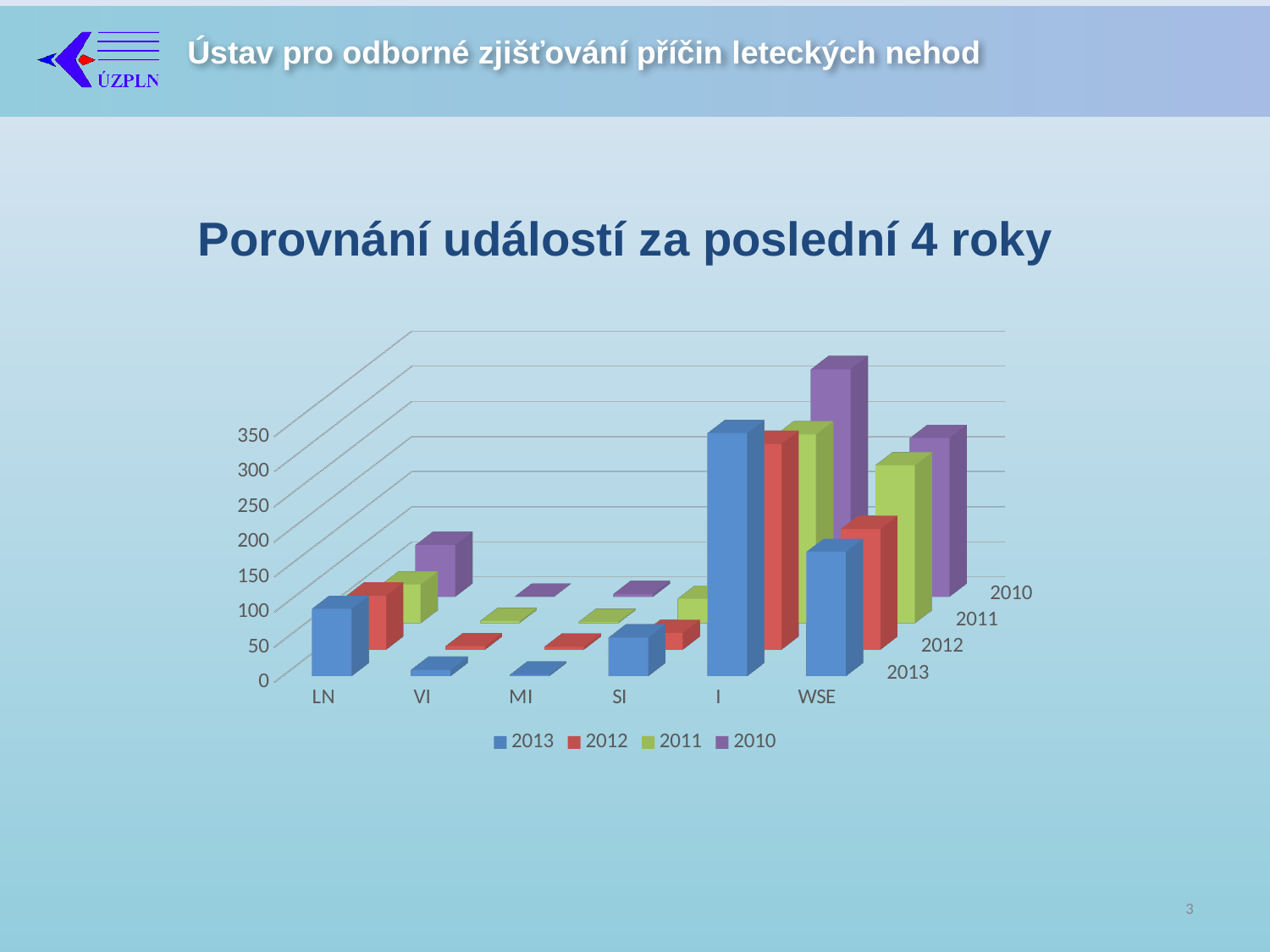
Is the 2013 value for I greater or less than 300? greater What is the title of the chart? Porovnání událostí za poslední 4 roky How many series does the legend list? 4 Is the 2013 value for LN greater or less than 50? greater For the 2013 series, which is larger: the value for LN or the value for SI? LN For the 2013 series, which is larger: the value for I or the value for WSE? I Which category has the highest value for the 2013 series? I Which colour represents the 2010 series in the legend? purple Is the 2013 value for VI greater or less than 50? less Which category has the lowest value for the 2013 series? MI What type of chart is shown on the slide? bar chart How many categories are shown on the x axis? 6